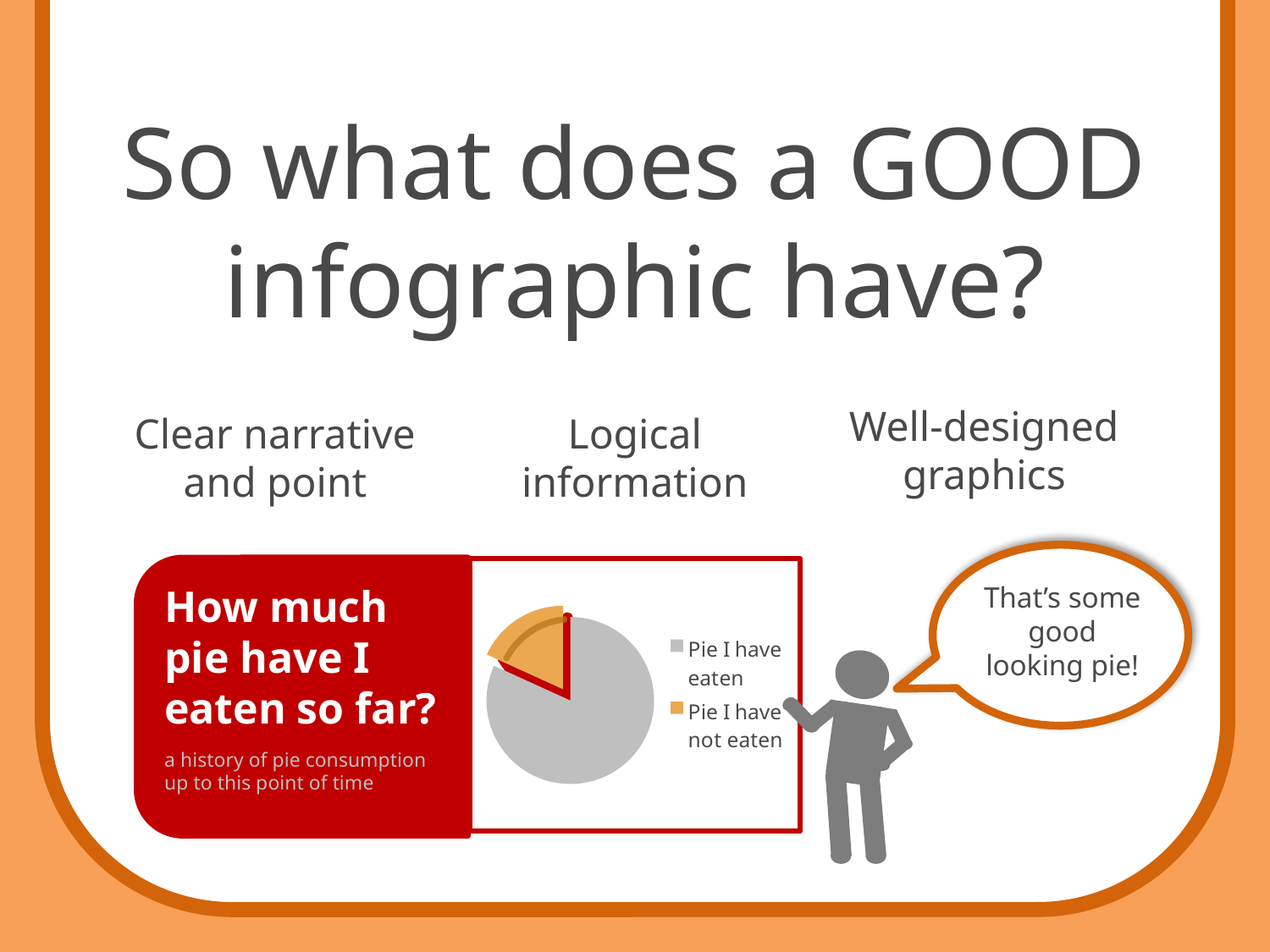
Which slice of the pie chart is the smallest? Pie I have not eaten How many slices does the pie chart have? 2 Which is larger in the pie chart, "Pie I have eaten" or "Pie I have not eaten"? Pie I have eaten What kind of chart is shown on the slide? pie chart What colour is the "Pie I have eaten" slice in the pie chart? gray Which slice of the pie chart is the largest? Pie I have eaten What are the two legend entries of the pie chart? Pie I have eaten; Pie I have not eaten How many entries does the pie chart's legend list? 2